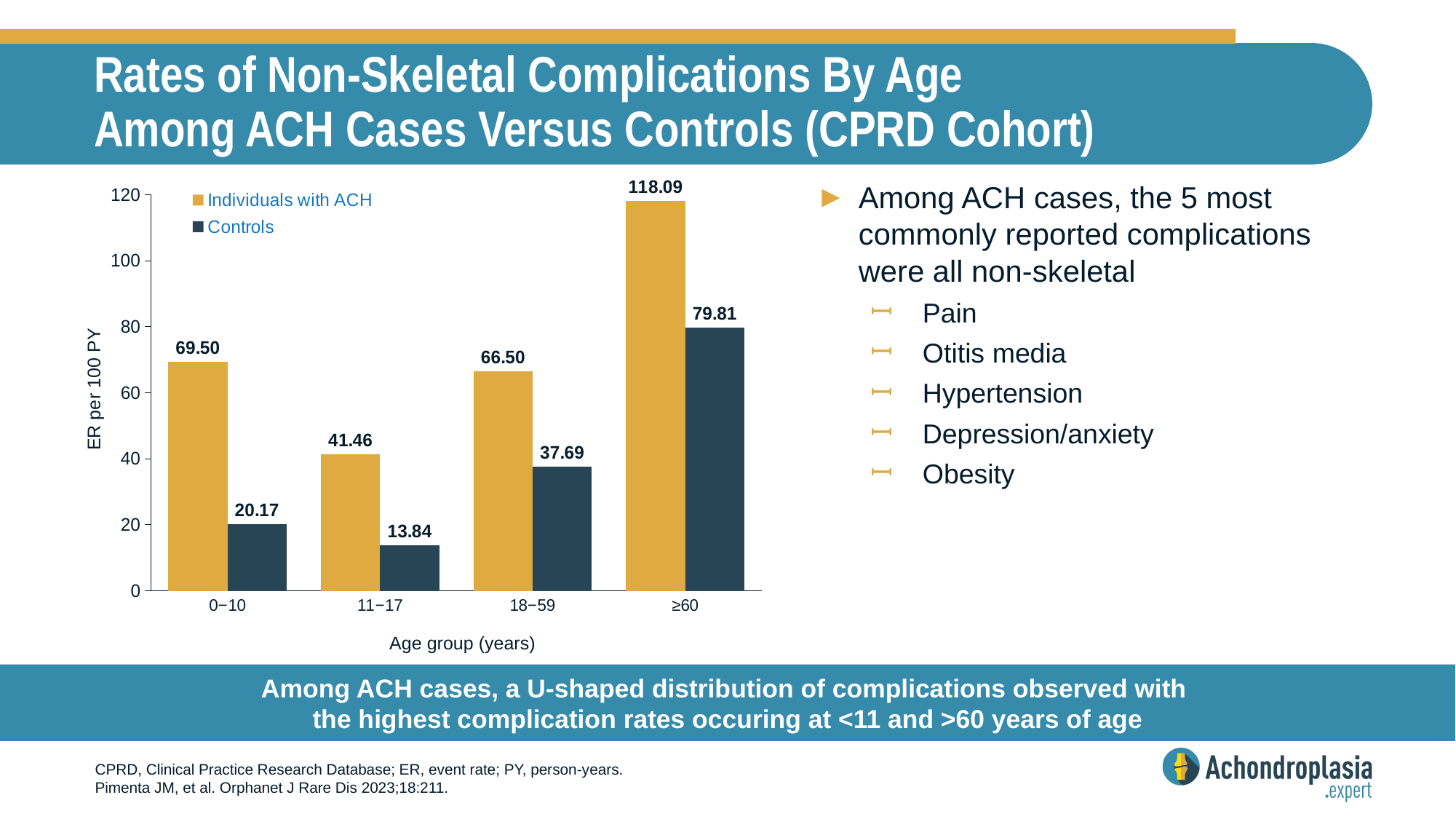
How many age groups are shown on the x axis? 4 What is the ER per 100 PY for Individuals with ACH in the 0–10 age group? 69.50 Which colour represents Controls in the chart? Dark blue How many series does the legend list? 2 What kind of chart is shown on the slide? Bar chart Which age group has the highest ER per 100 PY for Individuals with ACH? ≥60 What is the label of the y axis? ER per 100 PY In the 11–17 age group, which series has the higher ER per 100 PY: Individuals with ACH or Controls? Individuals with ACH Is the ER per 100 PY for Controls in the ≥60 age group greater or less than 60? greater What is the ER per 100 PY for Controls in the 18–59 age group? 37.69 What is the difference between the ER per 100 PY for Individuals with ACH and Controls in the ≥60 age group? 38.28 Which age group has the lowest ER per 100 PY for Controls? 11–17